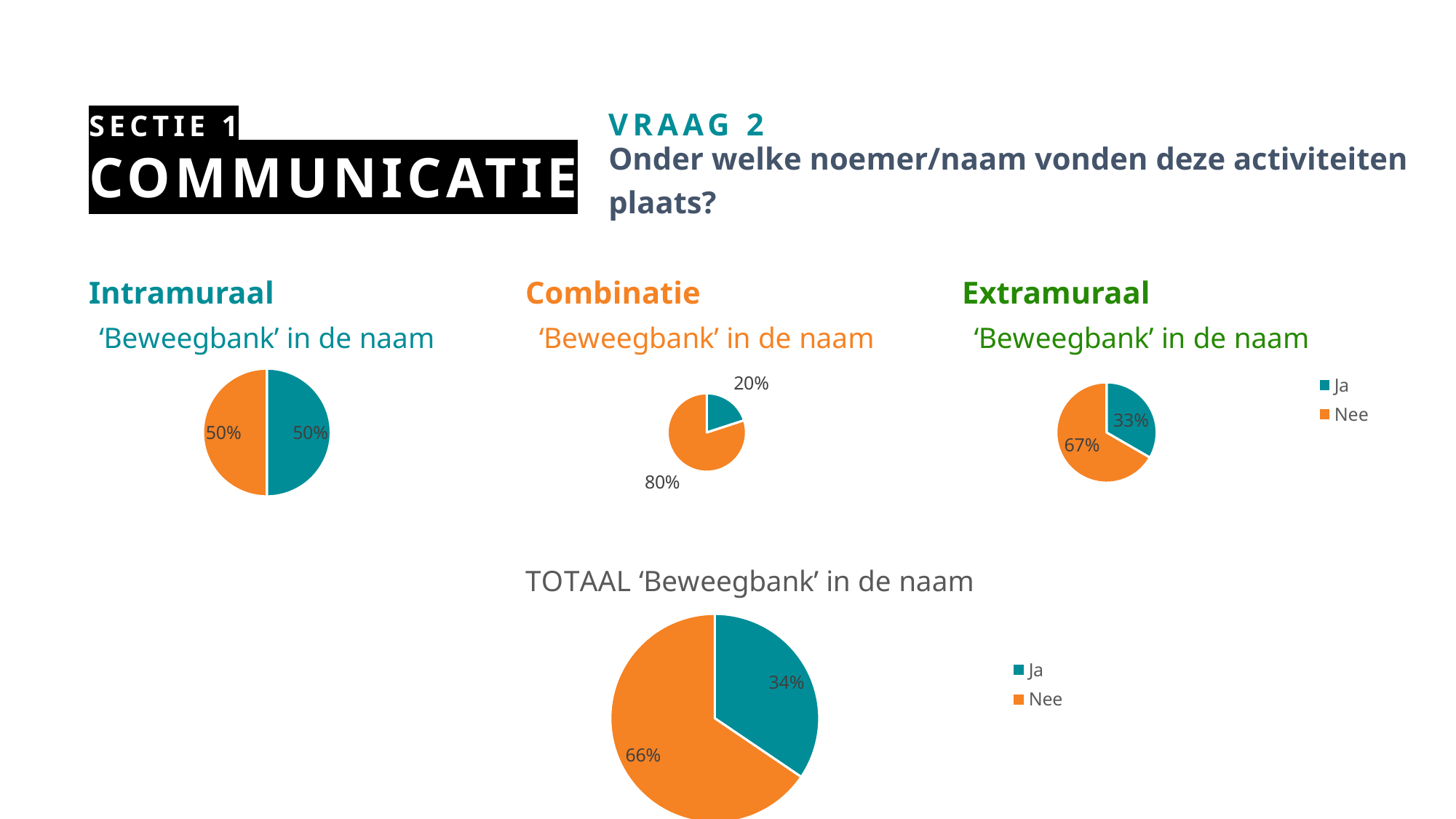
In the TOTAAL 'Beweegbank' in de naam pie chart, what percentage is shown for Nee? 66% In the Intramuraal 'Beweegbank' in de naam pie chart, what share is labelled for Ja? 50% In the Combinatie 'Beweegbank' in de naam pie chart, what percentage is shown for Ja? 20% In the Extramuraal 'Beweegbank' in de naam pie chart, what percentage is shown for Nee? 67% In the TOTAAL 'Beweegbank' in de naam pie chart, what percentage is shown for Ja? 34% In the TOTAAL 'Beweegbank' in de naam pie chart, which slice is larger, Ja or Nee? Nee How many entries does the legend of the TOTAAL 'Beweegbank' in de naam chart list? 2 What kind of chart is the TOTAAL 'Beweegbank' in de naam chart? Pie chart In the Extramuraal 'Beweegbank' in de naam pie chart, what percentage is shown for Ja? 33% In the Extramuraal 'Beweegbank' in de naam pie chart, which colour represents Nee? Orange In the Combinatie 'Beweegbank' in de naam pie chart, what is the difference in percentage points between Nee and Ja? 60 In the Combinatie 'Beweegbank' in de naam pie chart, what percentage is shown for Nee? 80%